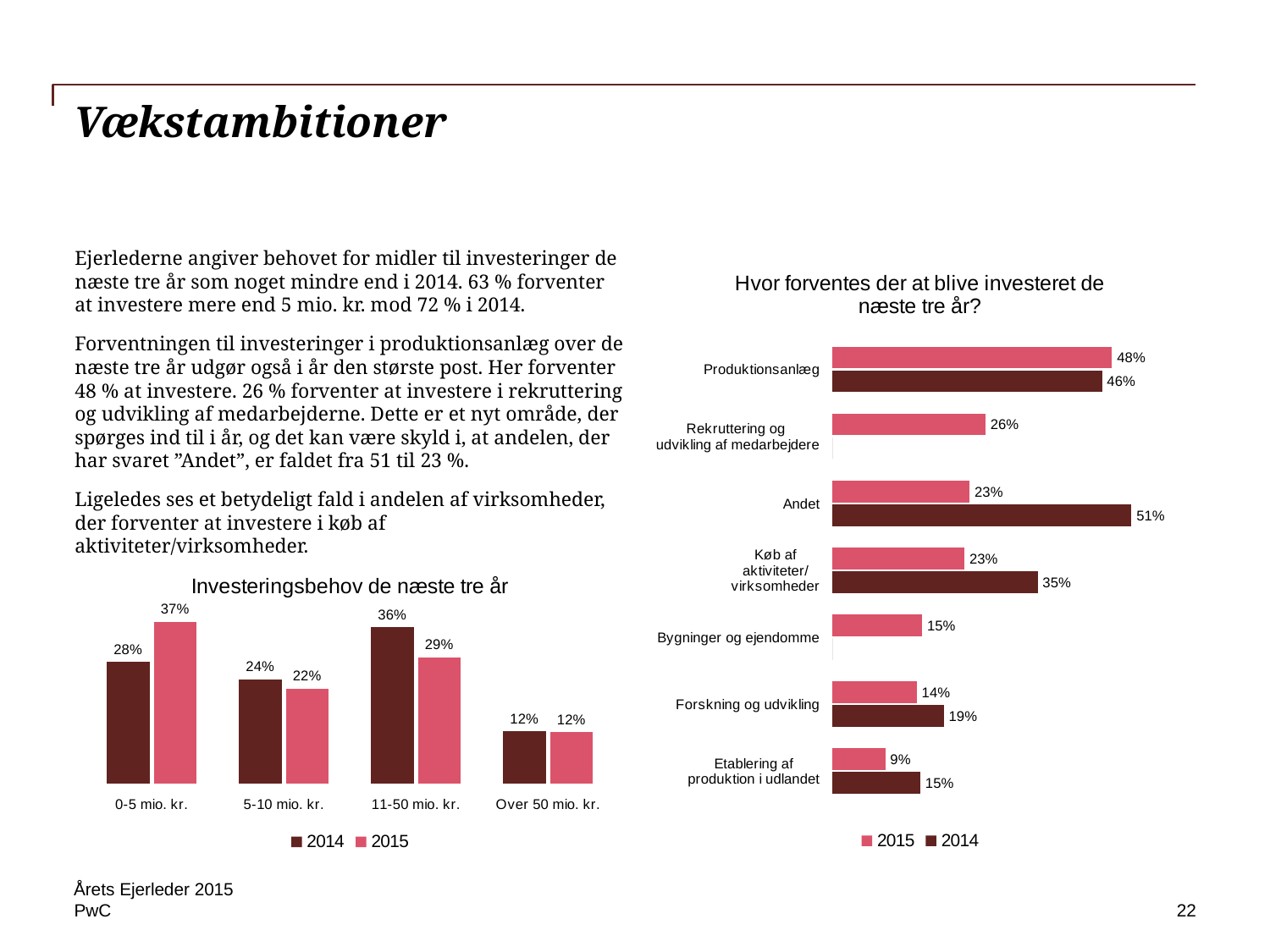
In the chart 'Investeringsbehov de næste tre år', what is the 2015 value for 0-5 mio. kr.? 37% In the chart 'Hvor forventes der at blive investeret de næste tre år?', what is the difference between the 2014 and 2015 values for Andet? 28 percentage points In the chart 'Hvor forventes der at blive investeret de næste tre år?', what is the 2014 value for Andet? 51% In the chart 'Investeringsbehov de næste tre år', what is the difference between the 2015 and 2014 values for 0-5 mio. kr.? 9 percentage points What type of chart is 'Hvor forventes der at blive investeret de næste tre år?'? Bar chart In the chart 'Investeringsbehov de næste tre år', how many categories are shown on the x axis? 4 In the chart 'Investeringsbehov de næste tre år', what is the 2014 value for 11-50 mio. kr.? 36% In the chart 'Hvor forventes der at blive investeret de næste tre år?', which is larger for Køb af aktiviteter/virksomheder: the 2015 value or the 2014 value? 2014 In the chart 'Hvor forventes der at blive investeret de næste tre år?', what is the 2015 value for Produktionsanlæg? 48% In the chart 'Hvor forventes der at blive investeret de næste tre år?', how many series does the legend list? 2 In the chart 'Investeringsbehov de næste tre år', which category has the lowest 2014 value? Over 50 mio. kr. In the chart 'Hvor forventes der at blive investeret de næste tre år?', which category has the highest 2015 value? Produktionsanlæg